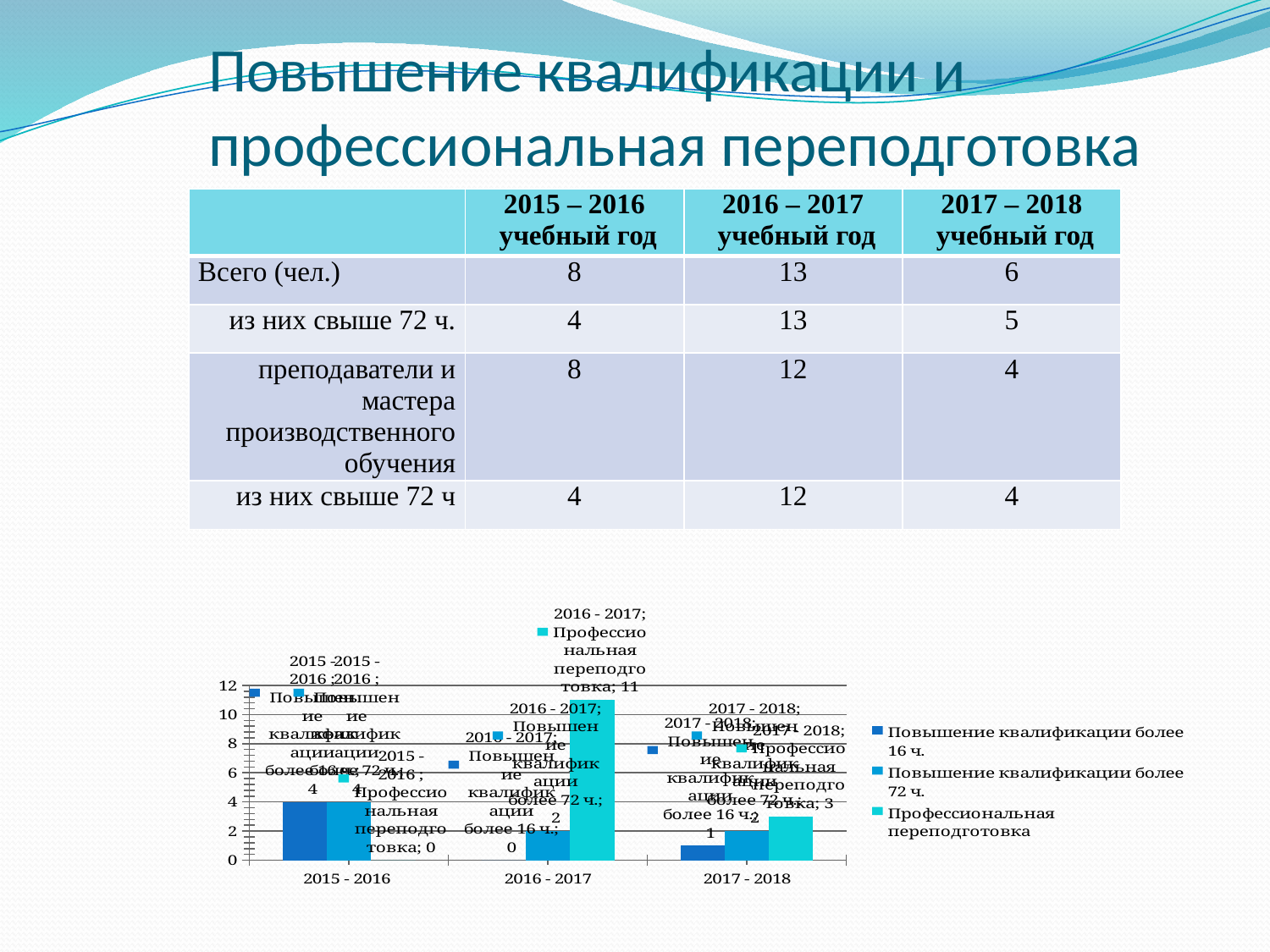
How many categories (academic years) are shown on the x axis of the chart? 3 In the chart, what is the value for Повышение квалификации более 16 ч. in 2017 - 2018? 1 In the chart, what is the value for Профессиональная переподготовка in 2015 - 2016? 0 In the chart, which is larger in 2017 - 2018: Профессиональная переподготовка or Повышение квалификации более 16 ч.? Профессиональная переподготовка How many series does the chart legend list? 3 In which academic year does Профессиональная переподготовка reach its highest value in the chart? 2016 - 2017 In the chart, what is the value for Профессиональная переподготовка in 2017 - 2018? 3 In the chart, what is the value for Повышение квалификации более 72 ч. in 2016 - 2017? 2 Is the value for Профессиональная переподготовка in 2016 - 2017 greater or less than 10? greater In the chart, what is the difference between Профессиональная переподготовка in 2016 - 2017 and in 2017 - 2018? 8 What kind of chart is shown at the bottom of the slide? bar chart In the chart, what is the value for Профессиональная переподготовка in 2016 - 2017? 11